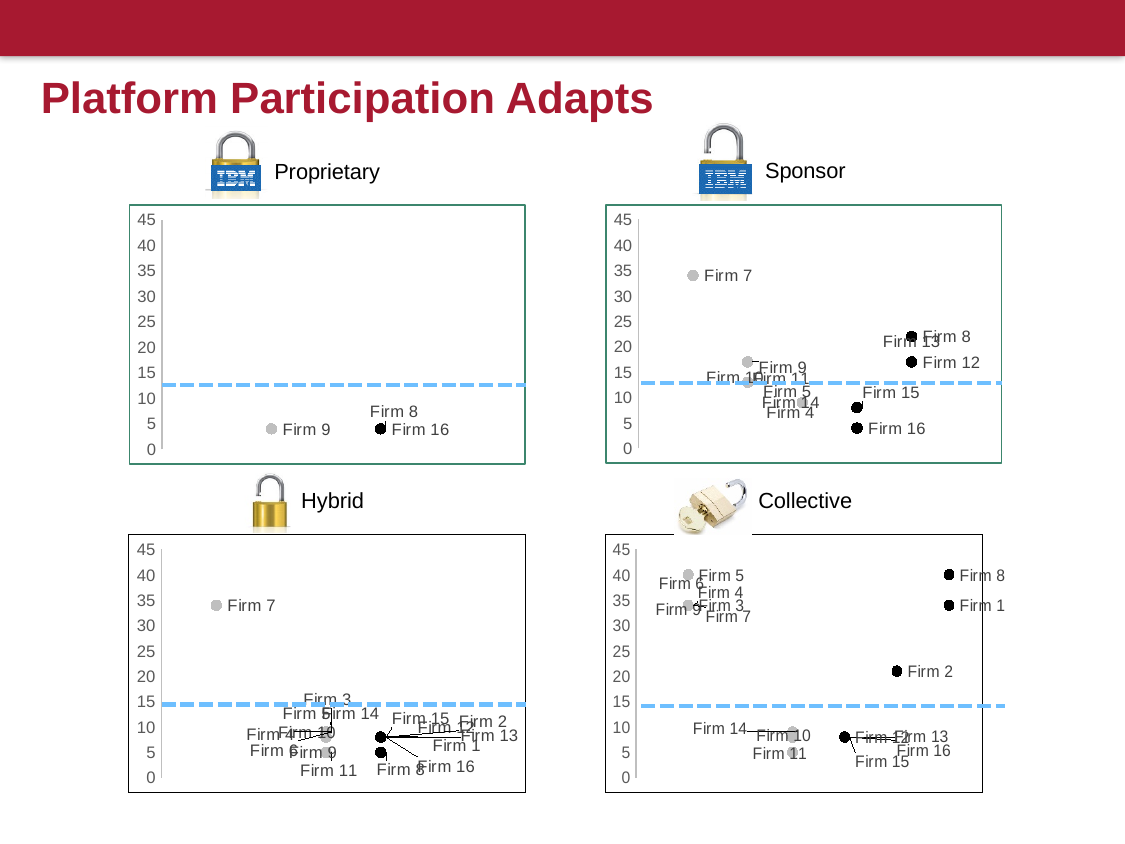
In the Proprietary chart, is the value for Firm 9 greater or less than 10? less What kind of chart is the Sponsor chart? scatter chart In the Collective chart, is the value for Firm 1 greater or less than 30? greater In the Sponsor chart, which is larger, the value for Firm 7 or the value for Firm 16? Firm 7 In the Hybrid chart, which firm has the highest value? Firm 7 In the Sponsor chart, which firm has the highest value? Firm 7 In the Sponsor chart, is the value for Firm 16 greater or less than 10? less How many charts are shown on the slide? 4 In the Collective chart, which is larger, the value for Firm 8 or the value for Firm 2? Firm 8 What are the titles of the four charts on the slide? Proprietary, Sponsor, Hybrid, Collective